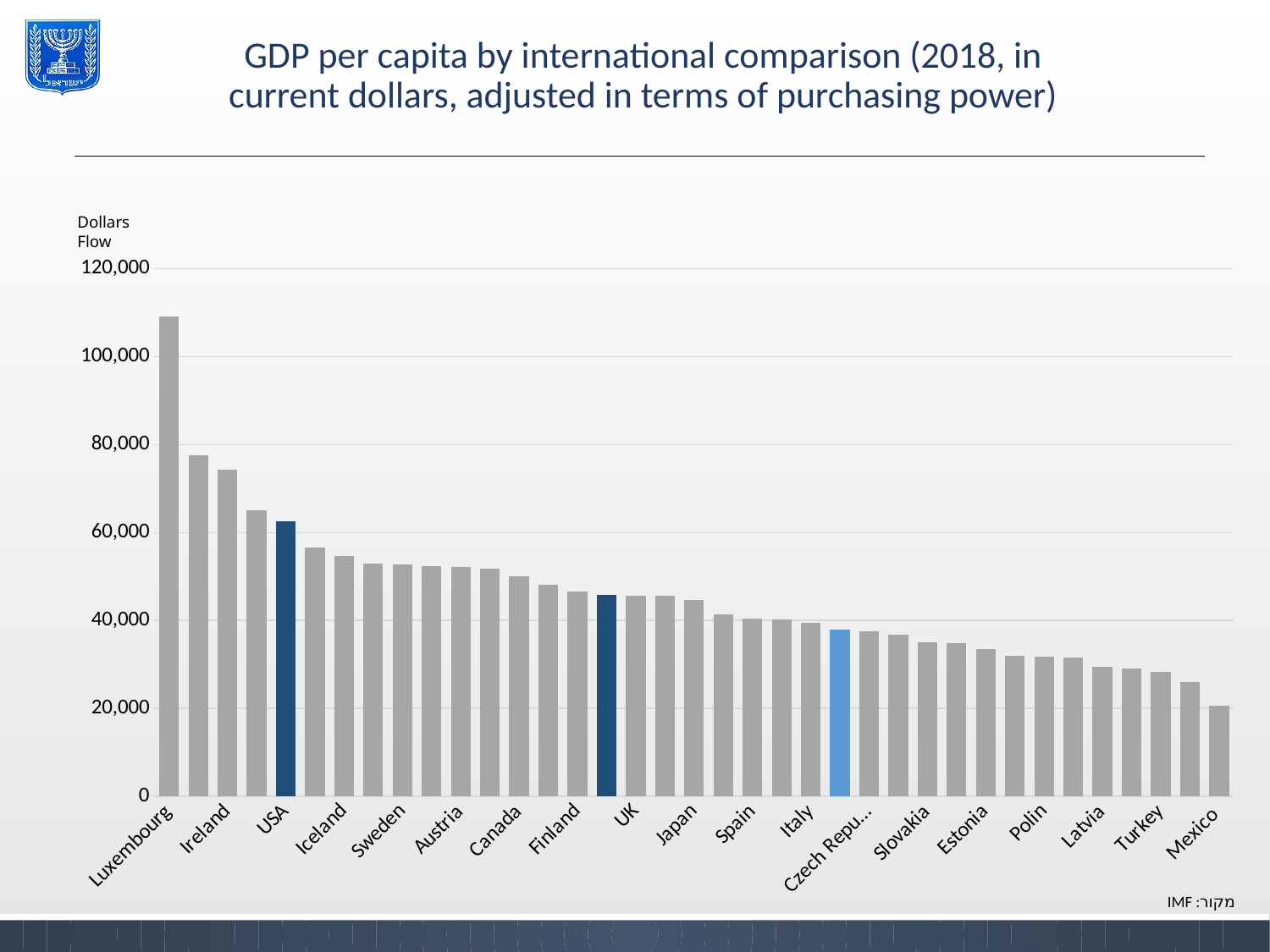
Which is larger, the value for Ireland or the value for USA? Ireland What colour are the bars for USA and UK? dark blue Is the value for Japan greater or less than 40,000? greater Is the value for Turkey greater or less than 40,000? less Is the value for Luxembourg greater or less than 100,000? greater Which country has the highest GDP per capita in the chart? Luxembourg Do the values rise or fall moving from left to right along the x axis? fall What is the title of the chart? GDP per capita by international comparison (2018, in current dollars, adjusted in terms of purchasing power) What kind of chart is shown on the slide? bar chart Which country has the lowest GDP per capita in the chart? Mexico